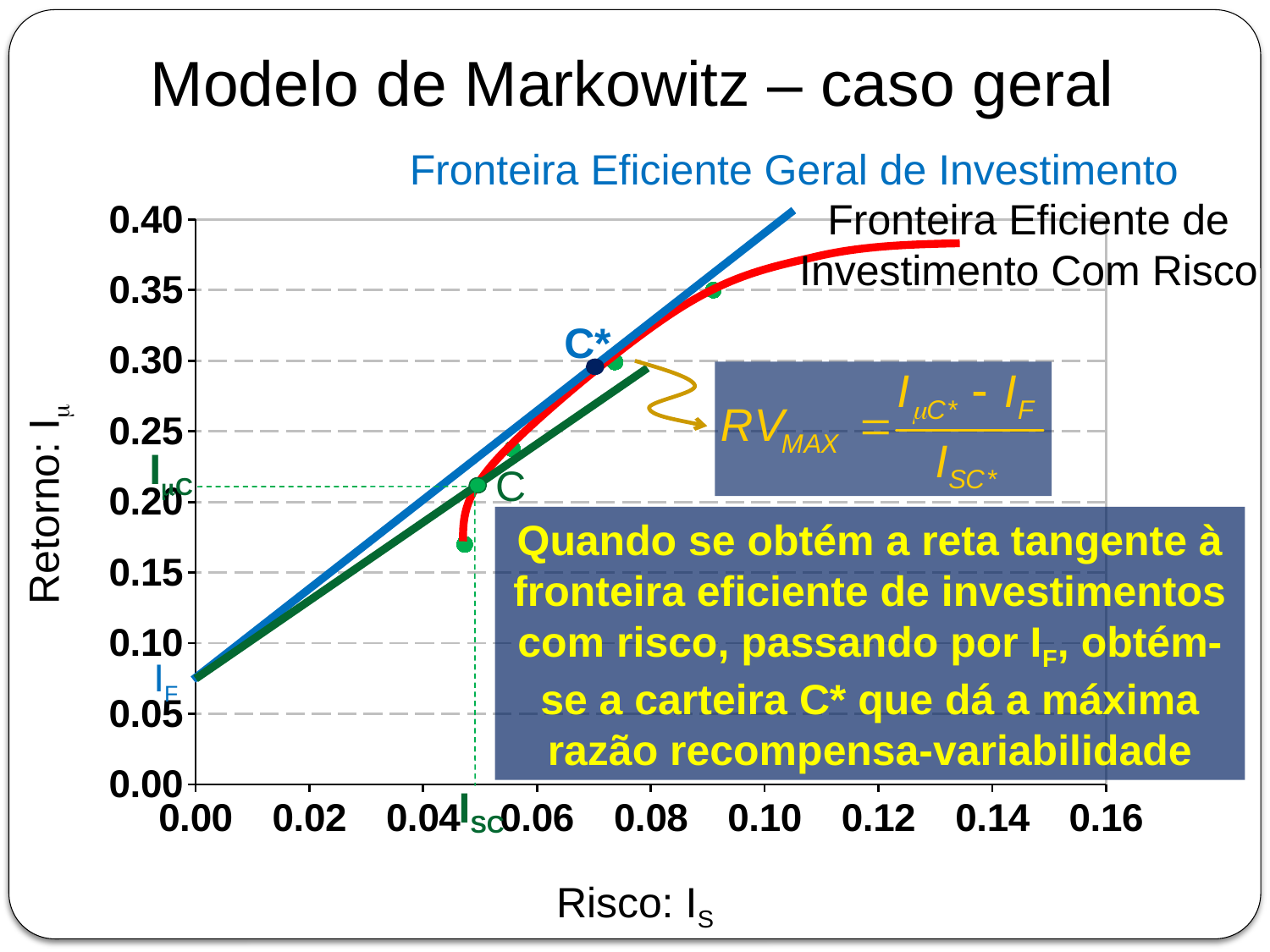
Is the return (y value) of point C greater or less than 0.25? less Is the risk (x value) of point C greater or less than 0.06? less What is the highest value shown on the y axis? 0.40 Is the risk (x value) of point C* greater or less than 0.08? less What is the label of the x axis? Risco: I_S Does the red curve (Fronteira Eficiente de Investimento Com Risco) rise or fall as risk increases beyond point C? rise What kind of chart is shown on the slide? line chart Which point has the higher return, C or C*? C*